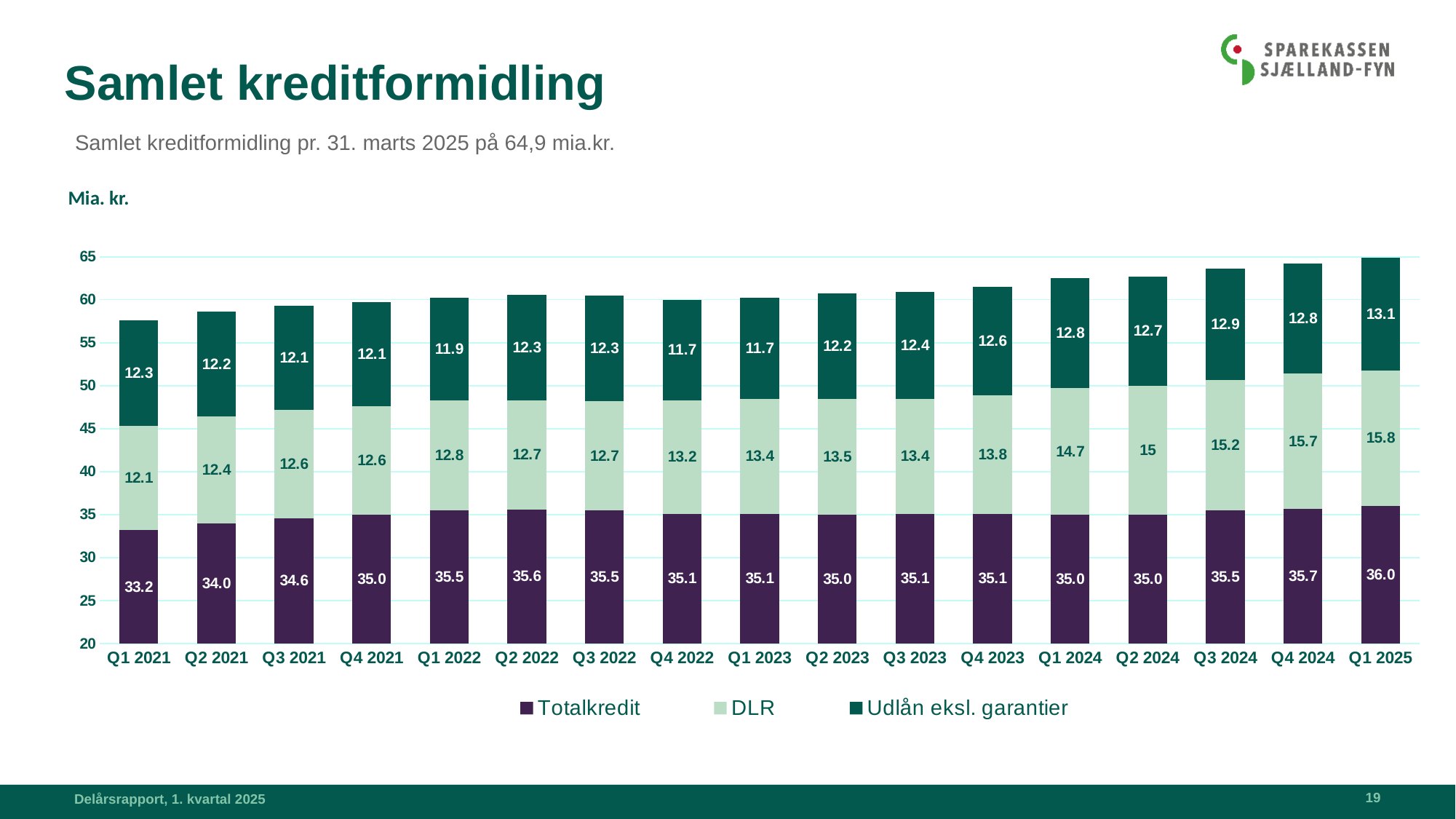
How many quarters are shown on the x axis? 17 How many series does the legend list? 3 What is the DLR value for Q2 2024? 15 In which quarter is the Totalkredit value highest? Q1 2025 What is the Totalkredit value for Q1 2025? 36.0 What kind of chart is shown on the slide? Stacked bar chart Which is larger, the Totalkredit value in Q2 2022 or in Q4 2024? Q4 2024 What is the Udlån eksl. garantier value for Q4 2022? 11.7 In which quarter is the DLR value lowest? Q1 2021 What is the difference between the DLR value in Q1 2025 and in Q1 2021? 3.7 What is the total of the stacked bar for Q1 2025? 64.9 Does the DLR value generally rise or fall from Q1 2021 to Q1 2025? Rise